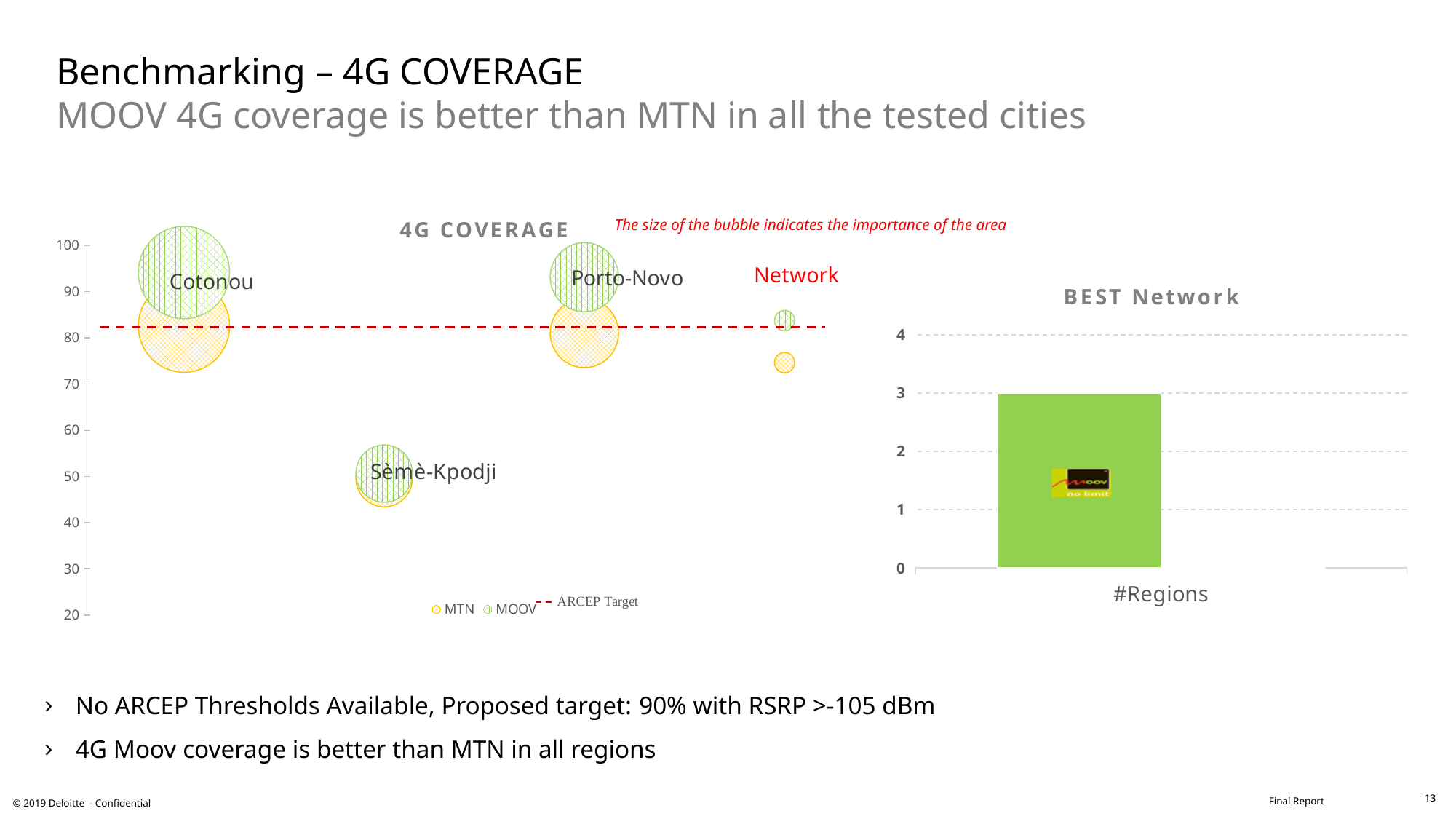
In the '4G COVERAGE' chart, is the MOOV value for Sèmè-Kpodji greater or less than 60? less In the '4G COVERAGE' chart, which is larger for Porto-Novo: the MOOV value or the MTN value? MOOV In the 'BEST Network' chart, what value does the MOOV bar reach for #Regions? 3 How many entries does the legend of the '4G COVERAGE' chart list? 3 In the '4G COVERAGE' chart, is the MOOV value for Cotonou greater or less than 80? greater In the '4G COVERAGE' chart, is the MTN value for Network greater or less than 80? less What is the highest value shown on the vertical axis of the 'BEST Network' chart? 4 How many bars are plotted in the 'BEST Network' chart? 1 What kind of chart is the 'BEST Network' chart on the right of the slide? bar chart In the '4G COVERAGE' chart, what does the red dashed line represent according to the legend? ARCEP Target In the '4G COVERAGE' chart, which city has the lowest MOOV coverage? Sèmè-Kpodji In the '4G COVERAGE' chart, which is larger: the MOOV value for Cotonou or the MOOV value for Sèmè-Kpodji? Cotonou